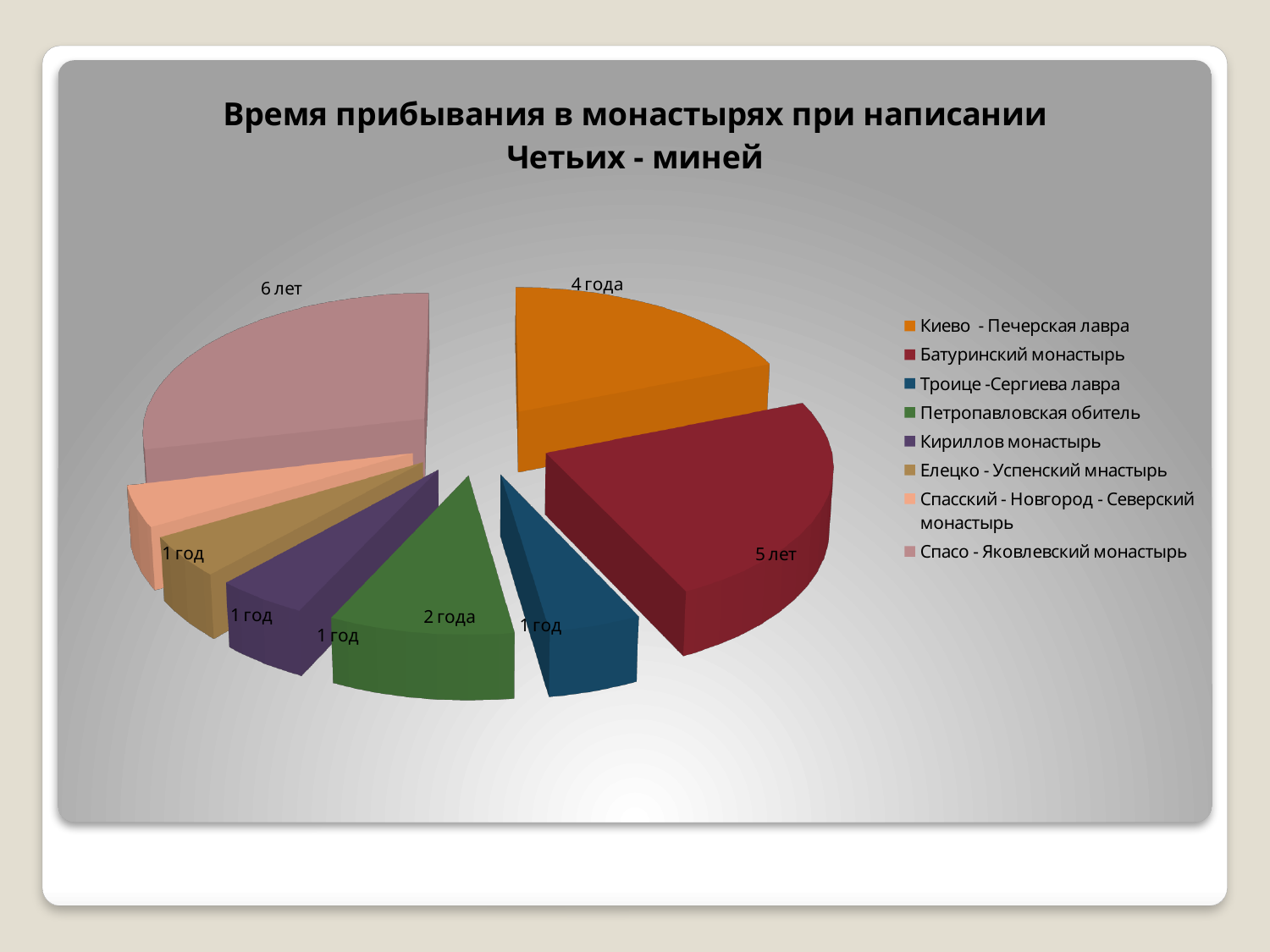
Which monastery has the largest slice of the pie? Спасо - Яковлевский монастырь What is the title of the chart? Время прибывания в монастырях при написании Четьих - миней What is the value shown for Петропавловская обитель? 2 года What is the value shown for Киево - Печерская лавра? 4 года What is the smallest value shown on any slice of the pie? 1 год What is the value shown for Спасо - Яковлевский монастырь? 6 лет By how many years does the value for Спасо - Яковлевский монастырь exceed the value for Петропавловская обитель? 4 What kind of chart is shown on the slide? pie chart How many entries does the legend list? 8 Which is larger: the value for Батуринский монастырь or the value for Киево - Печерская лавра? Батуринский монастырь What is the value shown for Батуринский монастырь? 5 лет How many slices does the pie chart have? 8